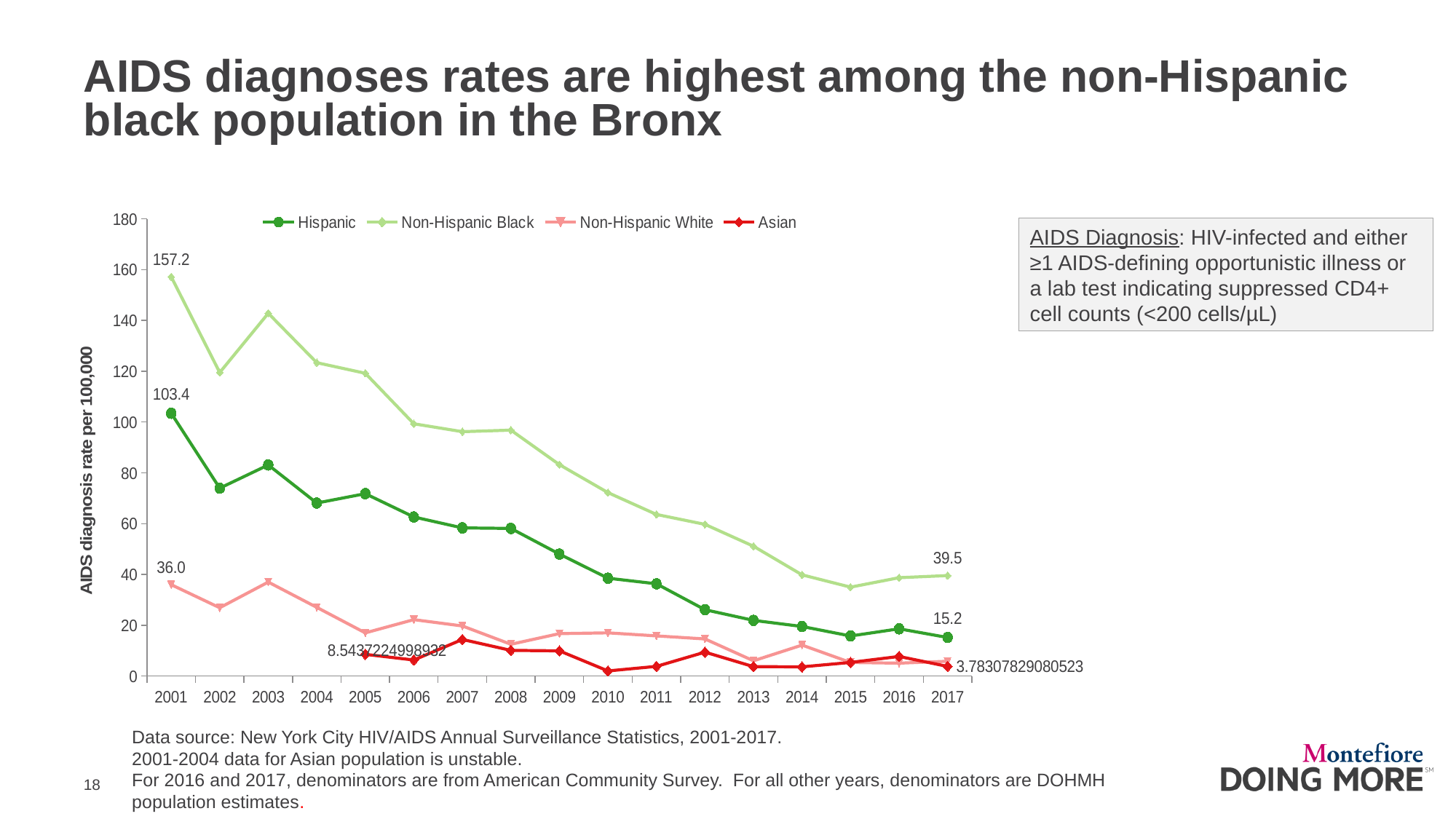
What is the AIDS diagnosis rate per 100,000 for the Non-Hispanic Black population in 2017? 39.5 What is the AIDS diagnosis rate per 100,000 for the Non-Hispanic White population in 2001? 36.0 What is the difference between the Non-Hispanic Black and Hispanic AIDS diagnosis rates in 2001? 53.8 What is the AIDS diagnosis rate per 100,000 for the Hispanic population in 2017? 15.2 What is the AIDS diagnosis rate per 100,000 for the Non-Hispanic Black population in 2001? 157.2 Which group had the highest AIDS diagnosis rate in 2001? Non-Hispanic Black How many series does the legend list? 4 What kind of chart is shown on the slide? Line chart Is the Non-Hispanic Black AIDS diagnosis rate in 2010 greater or less than 60? greater What is the AIDS diagnosis rate per 100,000 for the Hispanic population in 2001? 103.4 By how much did the Non-Hispanic Black AIDS diagnosis rate fall from 2001 to 2017? 117.7 Does the Non-Hispanic Black AIDS diagnosis rate generally rise or fall from 2001 to 2017? Fall